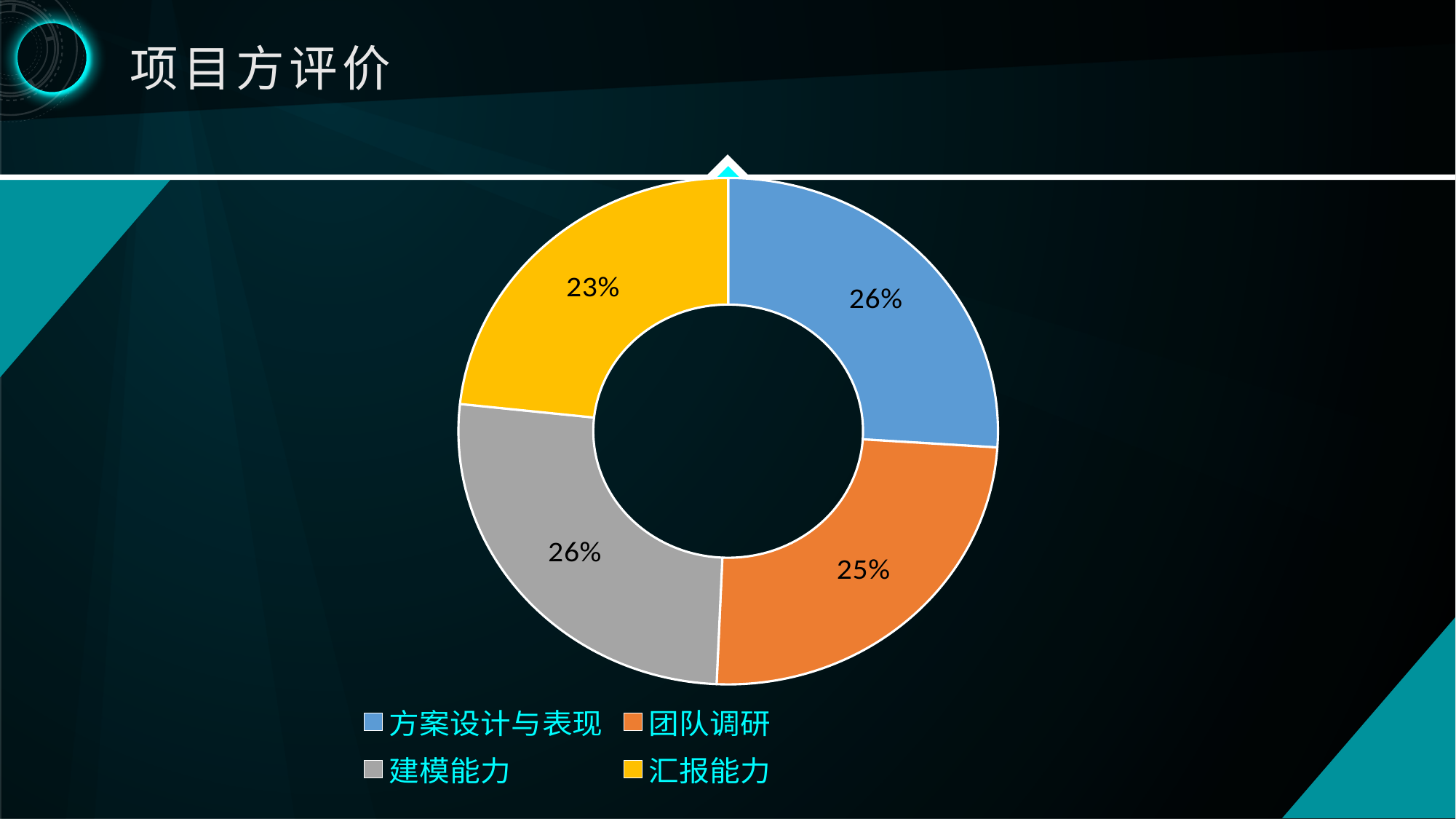
What percentage does the 汇报能力 slice represent? 23% Which colour represents 团队调研 in the chart? Orange What percentage does the 团队调研 slice represent? 25% What type of chart is shown on the slide? Doughnut chart Which is larger, the share for 团队调研 or the share for 汇报能力? 团队调研 What is the title of the slide containing the chart? 项目方评价 What percentage does the 方案设计与表现 slice represent? 26% What percentage does the 建模能力 slice represent? 26% What is the difference in percentage points between the 建模能力 share and the 团队调研 share? 1 percentage point What is the difference in percentage points between the 方案设计与表现 share and the 汇报能力 share? 3 percentage points Which category has the smallest share of the chart? 汇报能力 How many categories are shown in the chart? 4